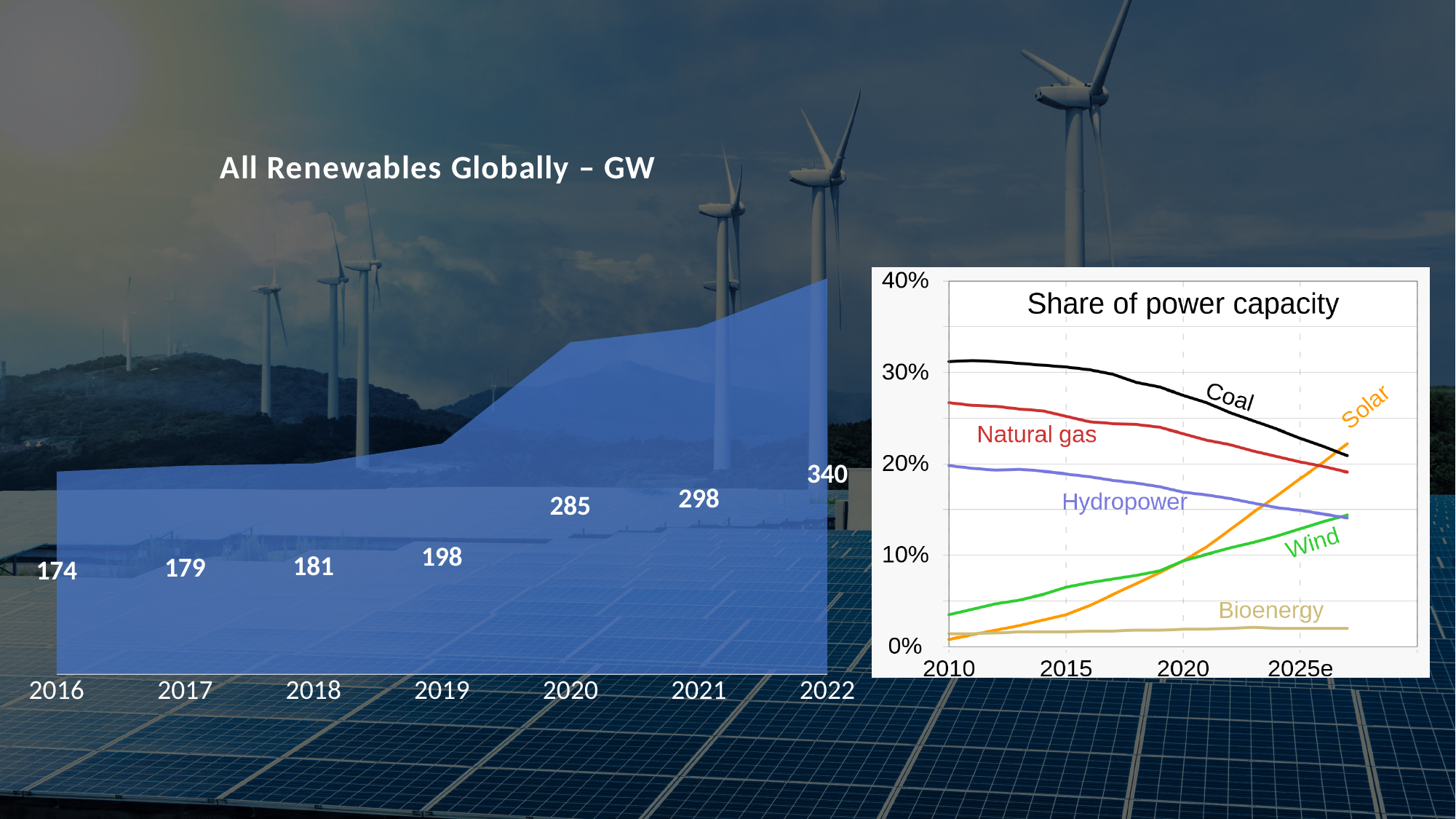
In the 'Share of power capacity' chart, does the Solar line rise or fall from 2010 to 2025e? rise In the 'All Renewables Globally – GW' chart, how many years are shown on the x axis? 7 In the 'All Renewables Globally – GW' chart, what is the value for 2019? 198 In the 'All Renewables Globally – GW' chart, what is the value for 2022? 340 What kind of chart is the 'All Renewables Globally – GW' chart? area chart In the 'Share of power capacity' chart, is the value for Coal in 2010 greater or less than 30%? greater In the 'Share of power capacity' chart, how many series are plotted? 6 In the 'All Renewables Globally – GW' chart, which year has the lowest value? 2016 In the 'All Renewables Globally – GW' chart, which year has the highest value? 2022 In the 'All Renewables Globally – GW' chart, do the values rise or fall from 2016 to 2022? rise In the 'All Renewables Globally – GW' chart, what is the difference between the 2020 and 2019 values? 87 In the 'Share of power capacity' chart, which series has the lowest share in 2010? Solar